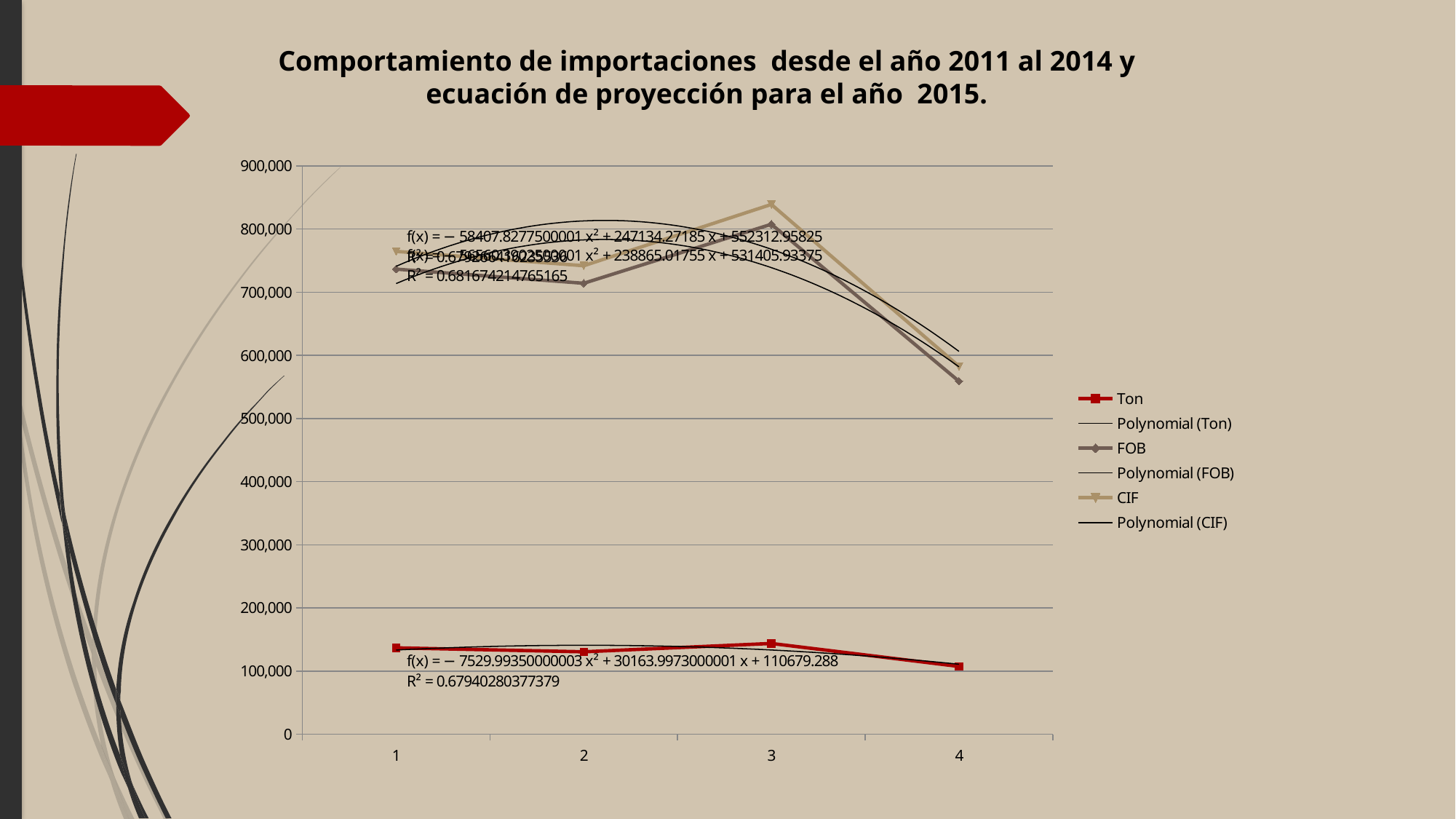
Do the values of the FOB series rise or fall from point 3 to point 4? fall What kind of chart is shown on the slide? line chart How many entries does the legend list? 6 Is the value of FOB at point 4 greater or less than 600,000? less Is the value of Ton at point 1 greater or less than 200,000? less At point 1, which series has the larger value, Ton or FOB? FOB Is the value of CIF at point 3 greater or less than 800,000? greater How many points are plotted along the x axis for each series? 4 Which series is drawn in red in the chart? Ton At which x-axis point does the CIF series reach its highest value? 3 At point 3, which series has the larger value, CIF or FOB? CIF At which x-axis point does the FOB series reach its lowest value? 4